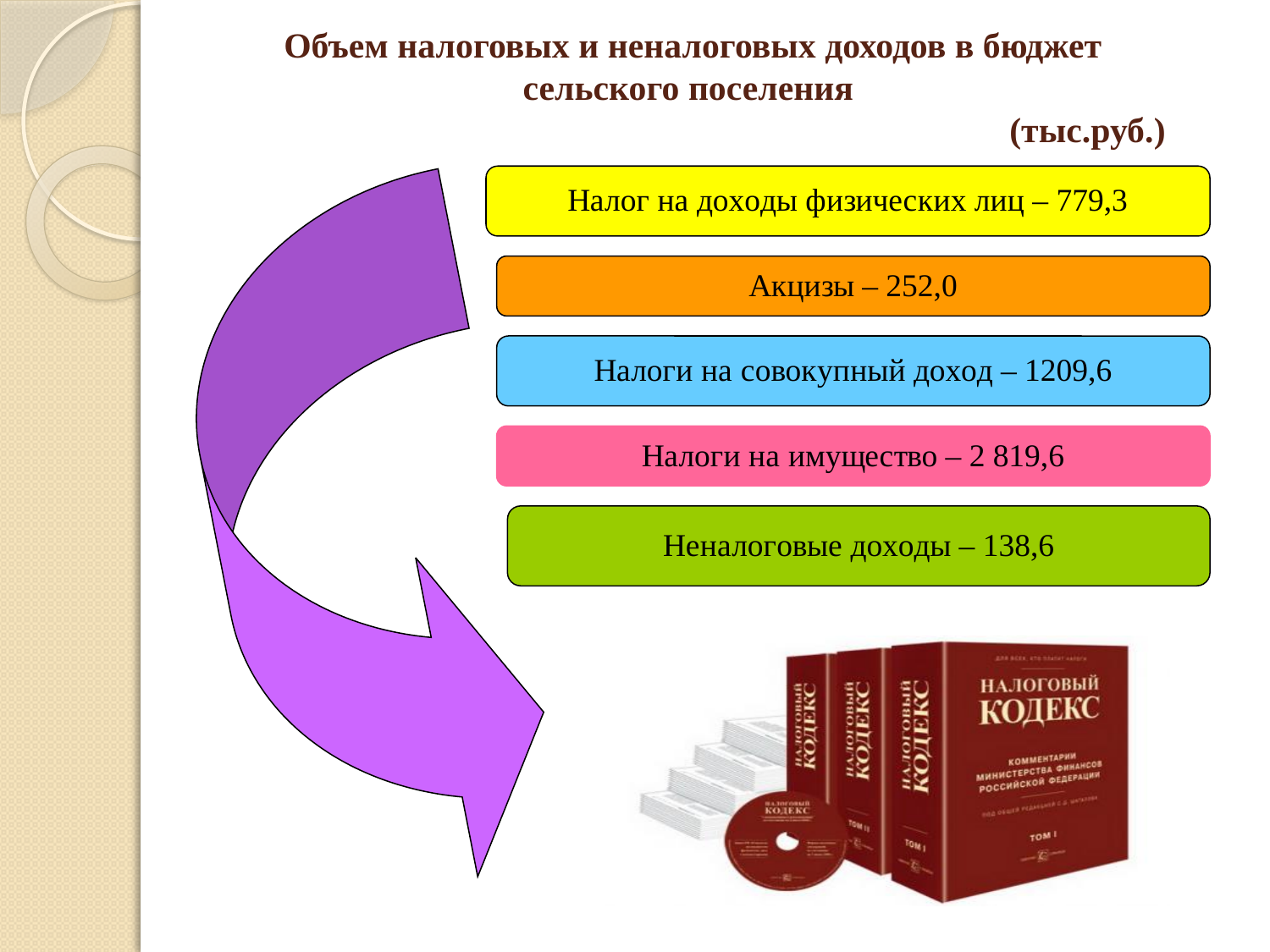
Which income category has the lowest value on the slide? Неналоговые доходы How many income categories are listed on the slide? 5 In what units are the values on the slide given? тыс.руб. What is the value shown for Налоги на имущество? 2 819,6 Which is larger: the value for Налоги на совокупный доход or the value for Налог на доходы физических лиц? Налоги на совокупный доход Which income category has the highest value on the slide? Налоги на имущество What is the value shown for Налоги на совокупный доход? 1209,6 What is the difference between the values for Налог на доходы физических лиц and Акцизы? 527,3 What is the value shown for Неналоговые доходы? 138,6 What is the total of all five income values listed on the slide? 5199,1 What is the value shown for Налог на доходы физических лиц? 779,3 What is the value shown for Акцизы? 252,0